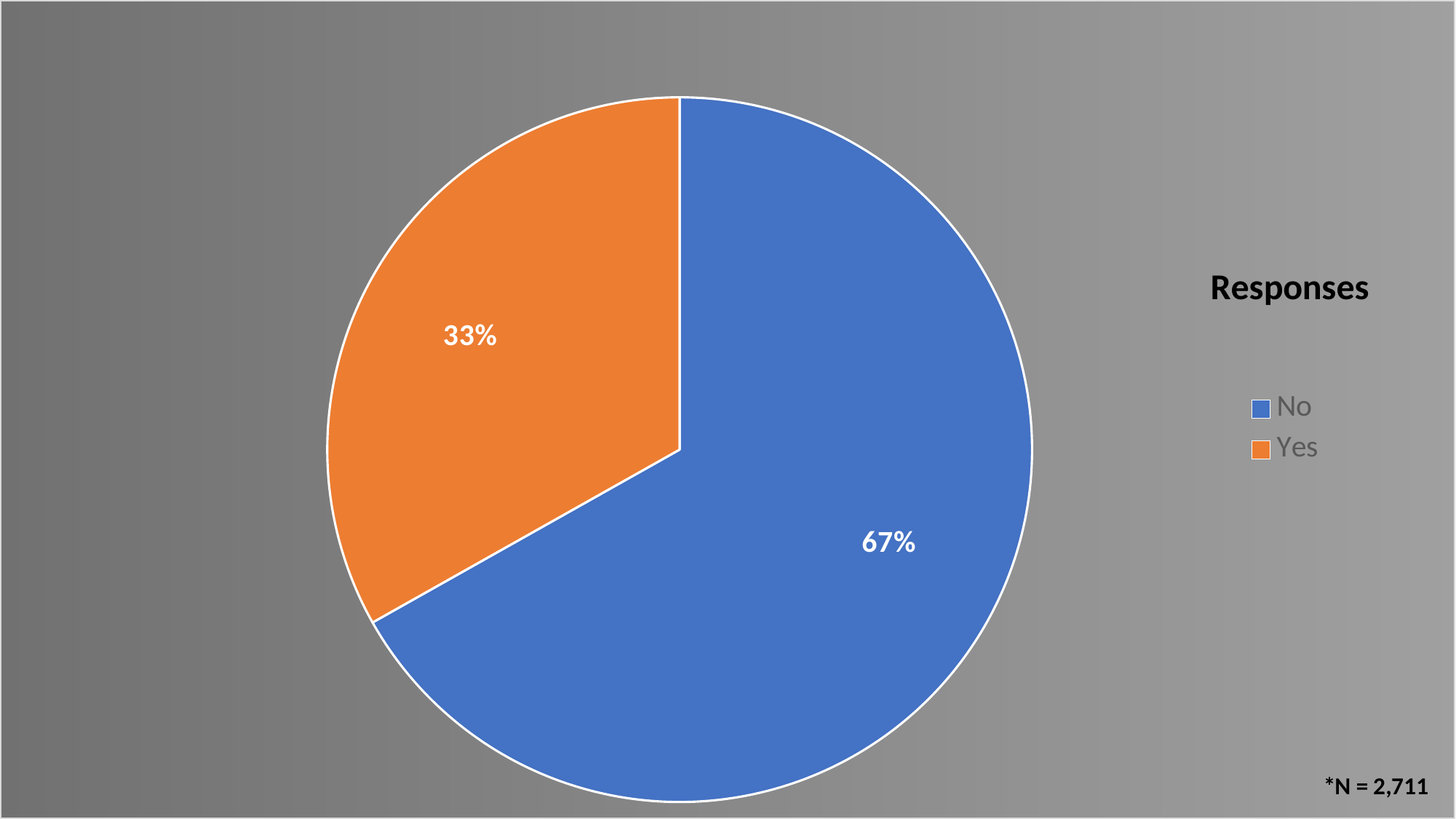
What share of responses is "Yes"? 33% What kind of chart is shown on the slide? pie chart What is the value of N given in the footnote? 2,711 What colour is the "Yes" slice? orange What is the difference in percentage points between the "No" share and the "Yes" share? 34 Which response has the smallest share of the pie? Yes Which response has the largest share of the pie? No How many entries does the legend list? 2 How many slices does the pie chart have? 2 What is the title of the legend? Responses What share of responses is "No"? 67% Which is larger, the share for "No" or the share for "Yes"? No